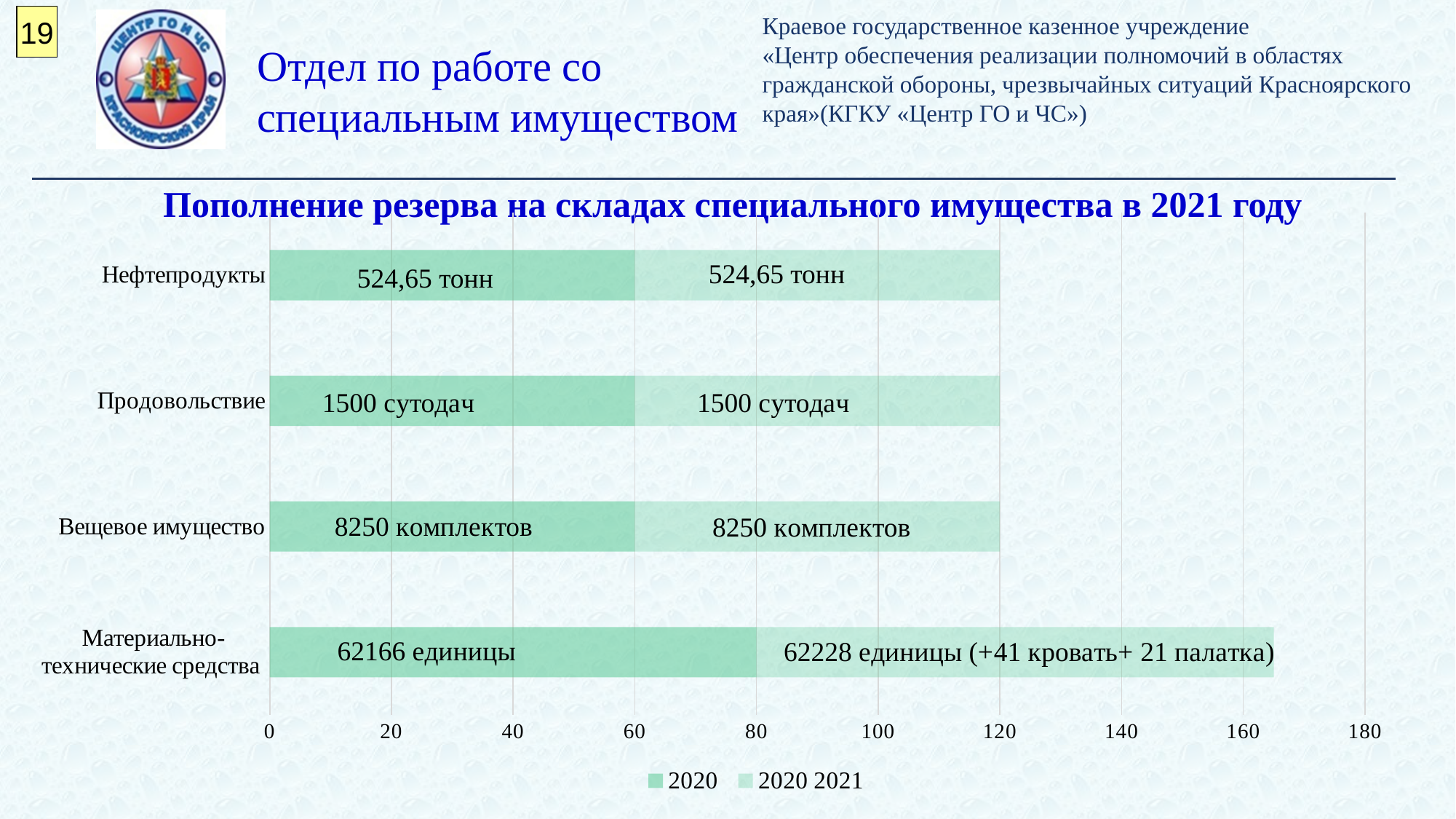
What is the title of the chart? Пополнение резерва на складах специального имущества в 2021 году What is the data label on the 2020 2021 bar for Вещевое имущество? 8250 комплектов What are the two series names listed in the legend? 2020 and 2020 2021 How many series does the legend list? 2 What is the data label on the 2020 bar for Продовольствие? 1500 сутодач How many categories are shown on the chart? 4 What is the data label on the 2020 bar for Материально-технические средства? 62166 единицы What is the data label on the 2020 bar for Нефтепродукты? 524,65 тонн What is the data label on the 2020 bar for Вещевое имущество? 8250 комплектов Which category has the longest total bar on the chart? Материально-технические средства What is the data label on the 2020 2021 bar for Материально-технические средства? 62228 единицы (+41 кровать+ 21 палатка) What kind of chart is shown on the slide? bar chart